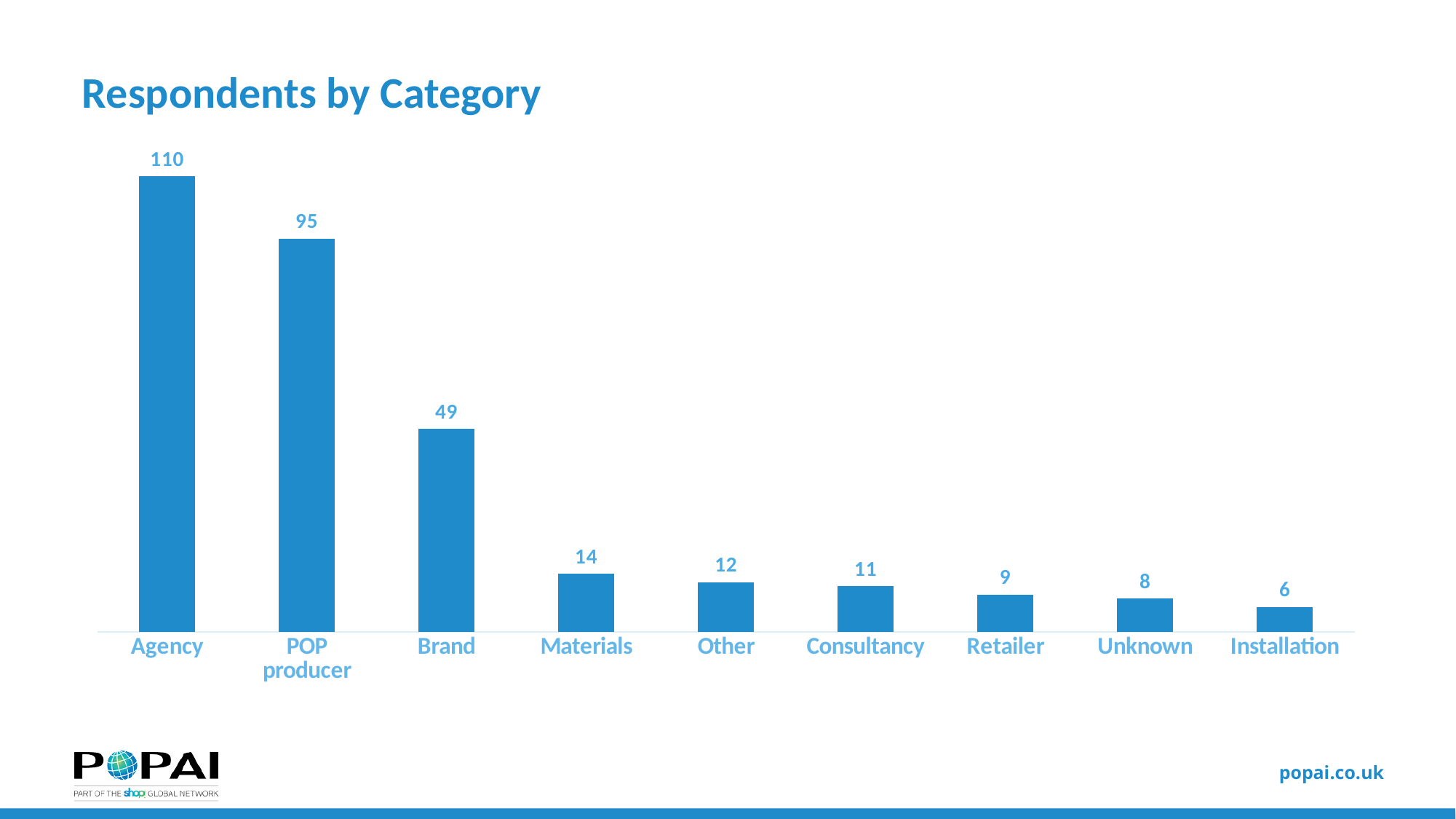
What is the difference between the values for Brand and Materials? 35 Which is larger, the value for Other or the value for Retailer? Other What is the value for POP producer? 95 What is the value for Consultancy? 11 Which category has the highest value? Agency What kind of chart is this? Bar chart How many categories are shown in the chart? 9 What is the value for Brand? 49 Which category has the lowest value? Installation What is the value for Agency? 110 What is the title of the chart? Respondents by Category What is the difference between the values for Agency and POP producer? 15